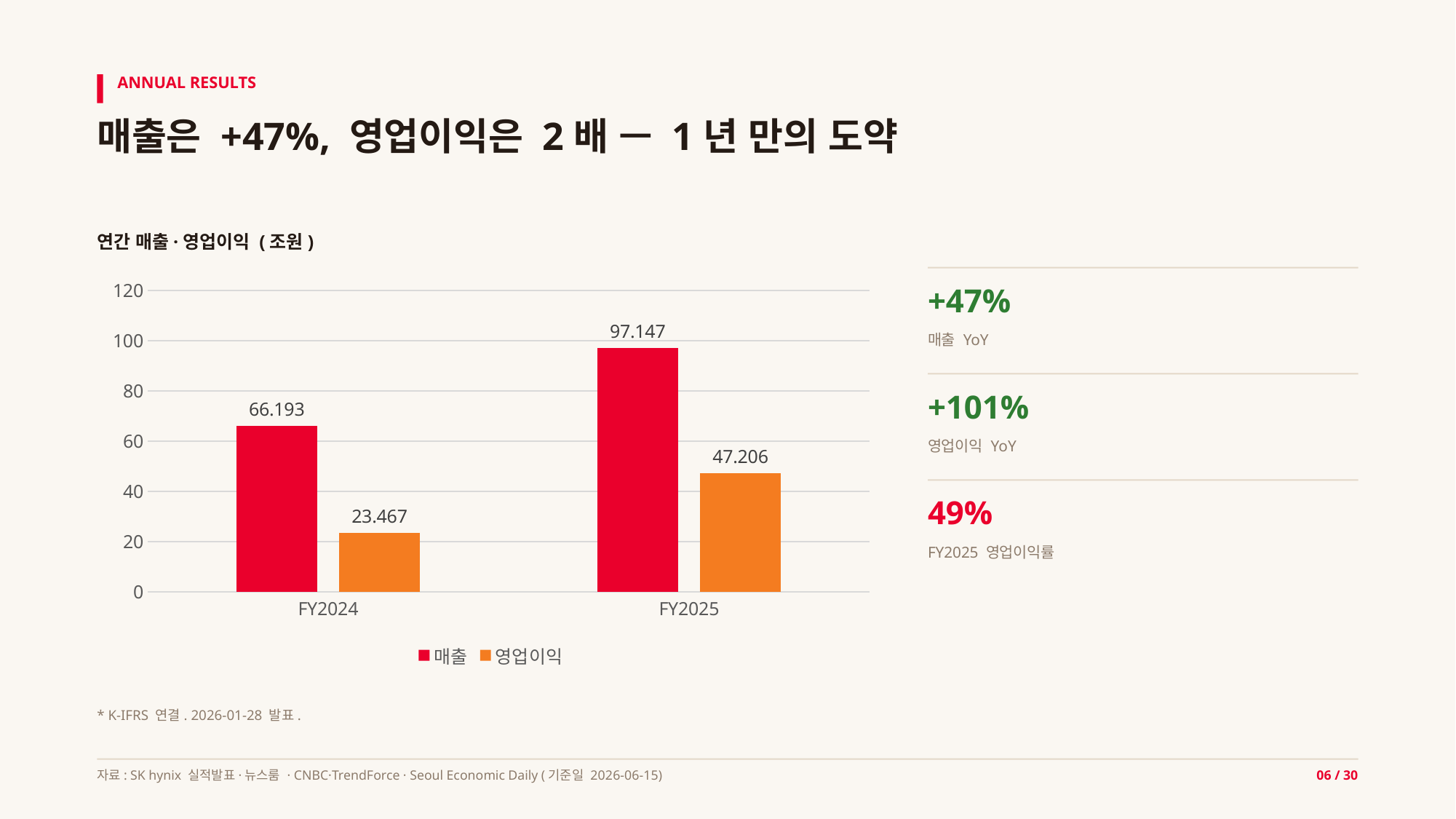
Which year has the lower 영업이익 value? FY2024 What is the 영업이익 value for FY2024? 23.467 Is the 영업이익 value for FY2025 greater or less than 40? greater What is the 매출 value for FY2024? 66.193 What kind of chart is shown on the slide? Bar chart What is the 매출 value for FY2025? 97.147 How many series does the legend list? 2 Does the 영업이익 series rise or fall from FY2024 to FY2025? Rise By how much did 매출 increase from FY2024 to FY2025? 30.954 What is the 영업이익 value for FY2025? 47.206 Which year has the higher 매출 value? FY2025 What is the difference between 매출 and 영업이익 in FY2025? 49.941